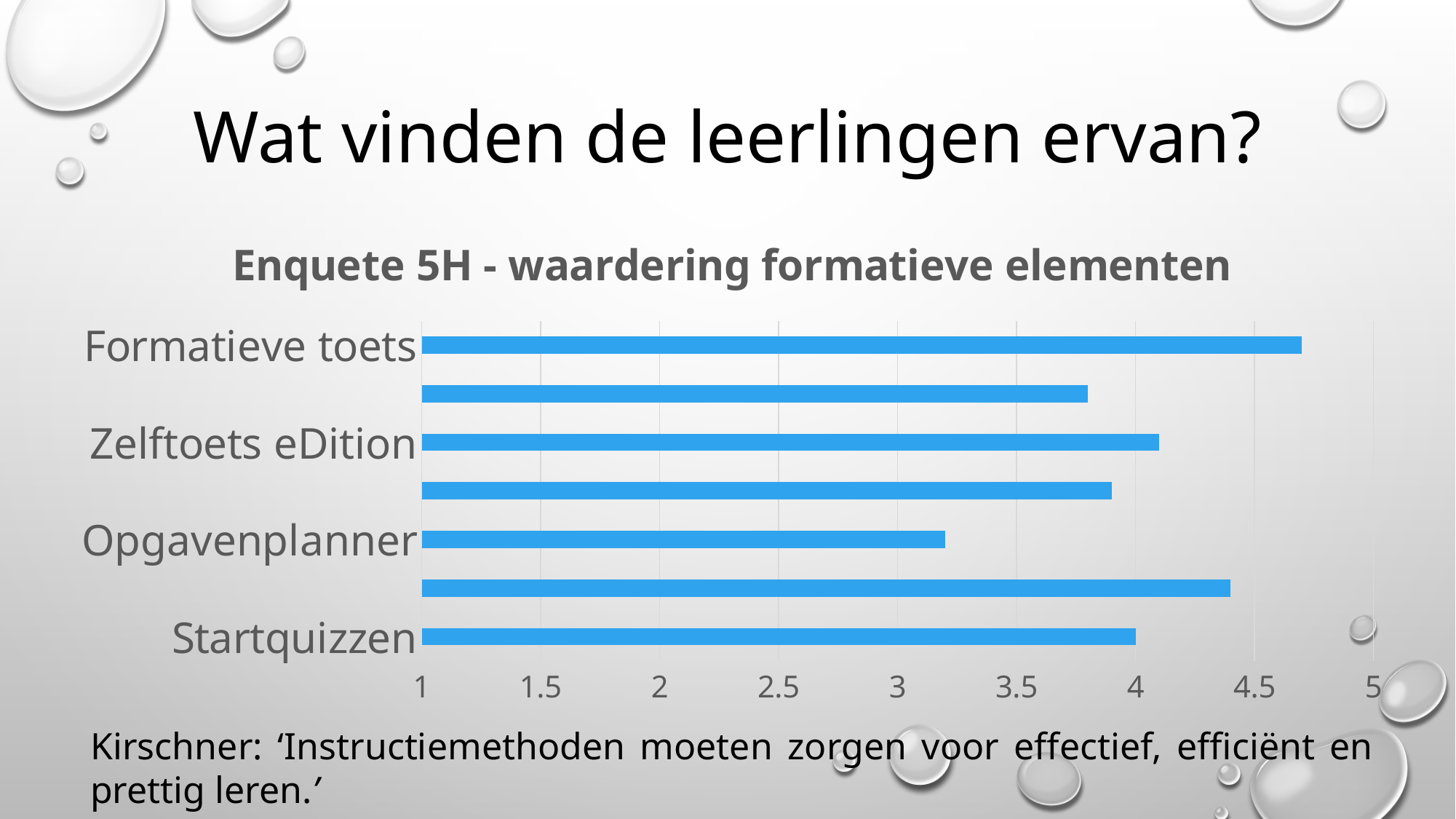
How many bars are plotted in the chart? 7 What are the minimum and maximum values shown on the horizontal axis? 1 and 5 Is the value for Formatieve toets greater or less than 4.5? greater Is the value for Opgavenplanner greater or less than 3.5? less Which is larger, the value for Zelftoets eDition or the value for Opgavenplanner? Zelftoets eDition What kind of chart is shown on the slide? Bar chart What is the title of the chart? Enquete 5H - waardering formatieve elementen Is the value for Zelftoets eDition greater or less than 3.5? greater Which labelled category has the highest value in the chart? Formatieve toets Which is larger, the value for Formatieve toets or the value for Opgavenplanner? Formatieve toets Which labelled category has the lowest value in the chart? Opgavenplanner